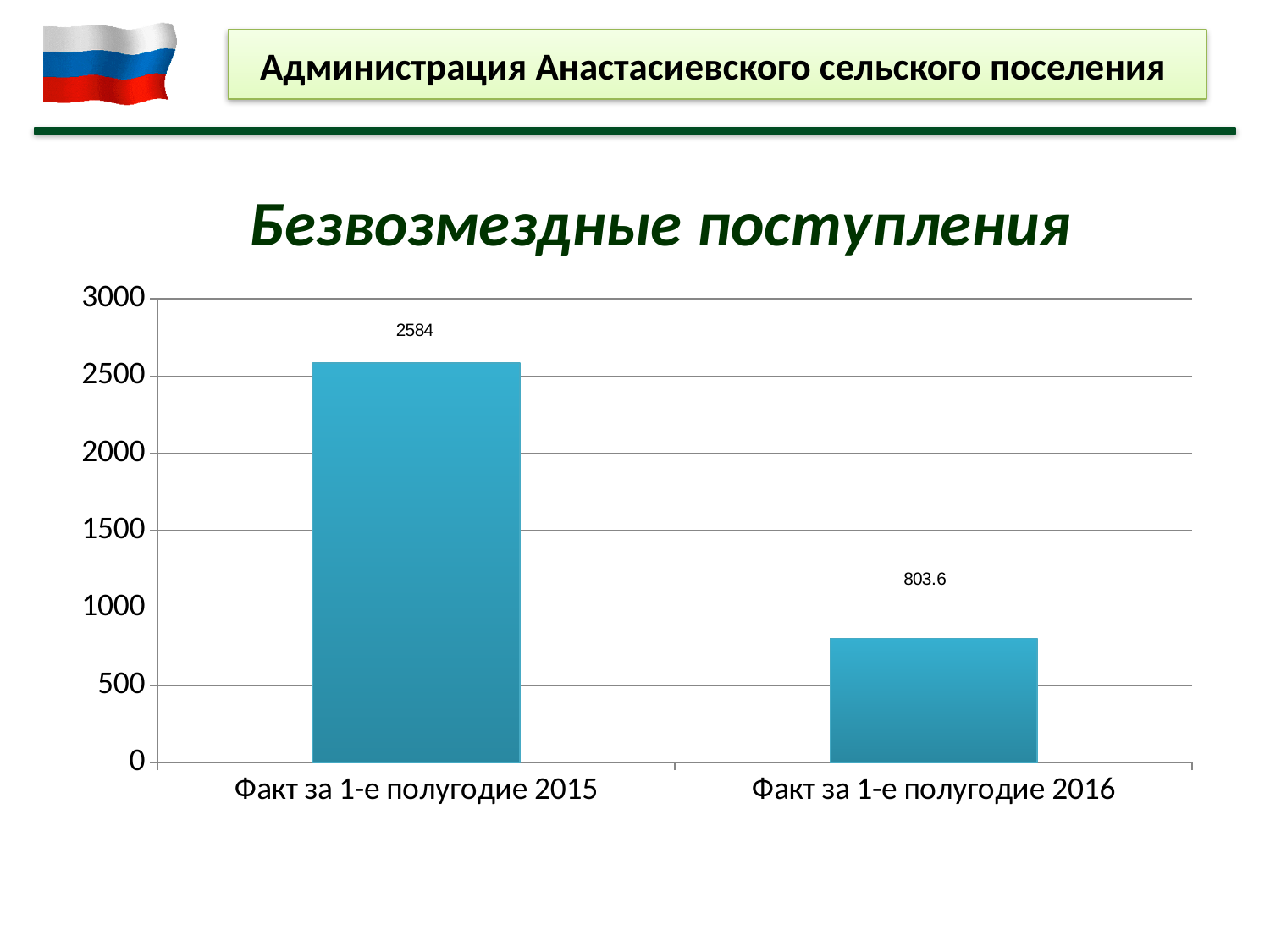
Is the value for Факт за 1-е полугодие 2015 greater or less than 2500? greater Which is larger: the value for Факт за 1-е полугодие 2015 or for Факт за 1-е полугодие 2016? Факт за 1-е полугодие 2015 What is the value for Факт за 1-е полугодие 2015? 2584 What is the title of the chart? Безвозмездные поступления What is the value for Факт за 1-е полугодие 2016? 803.6 What is the difference between the values for Факт за 1-е полугодие 2015 and Факт за 1-е полугодие 2016? 1780.4 What kind of chart is shown on the slide? bar chart How many categories are shown on the chart? 2 Which category has the highest value? Факт за 1-е полугодие 2015 Which category has the lowest value? Факт за 1-е полугодие 2016 Is the value for Факт за 1-е полугодие 2016 greater or less than 1000? less Do the values rise or fall from 2015 to 2016? fall